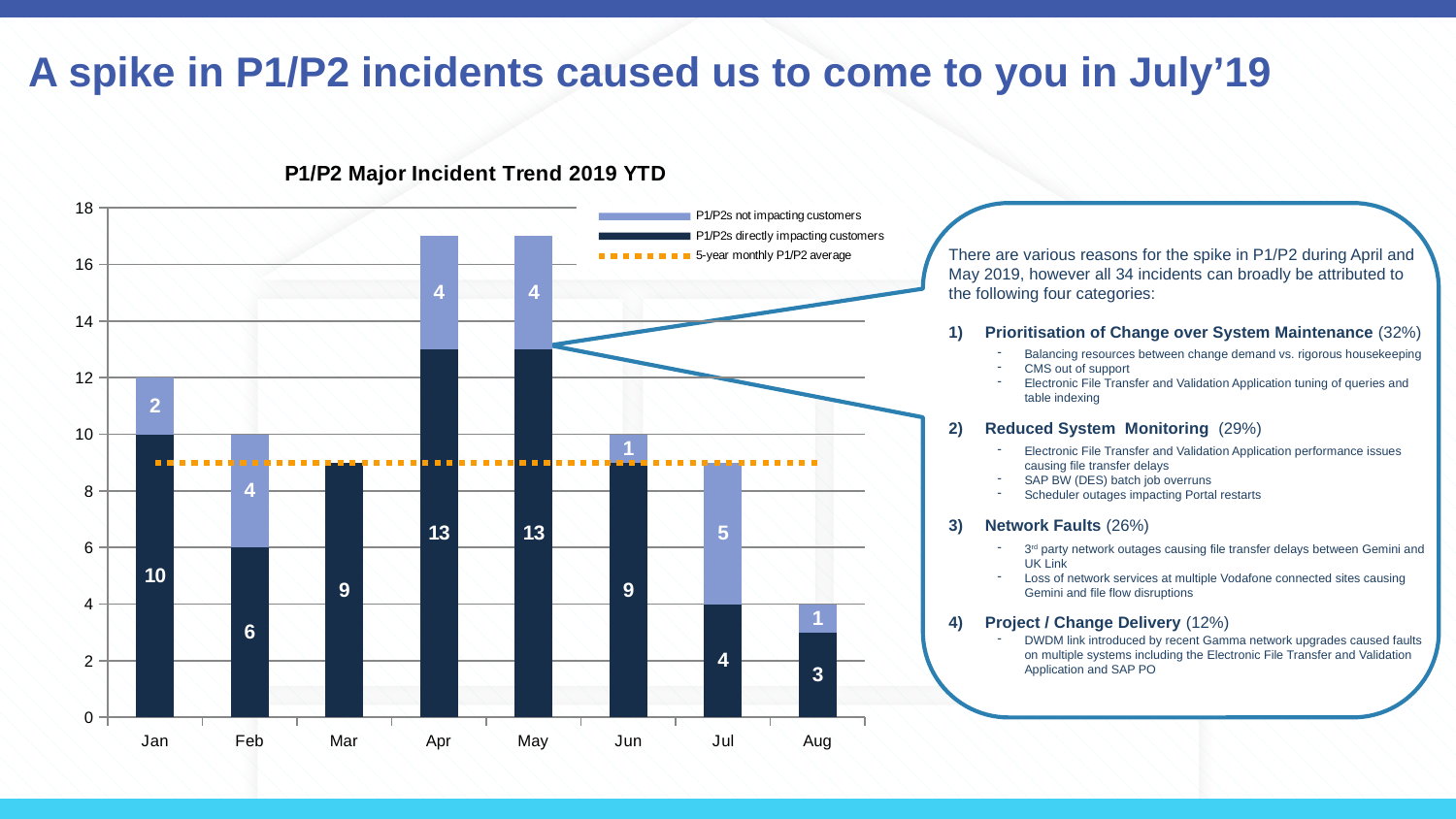
How many P1/P2s not impacting customers were there in Jul? 5 Is the 5-year monthly P1/P2 average line greater or less than 10? less What is the total height of the stacked bar for Aug? 4 What is the total height of the stacked bar for Apr? 17 What kind of chart is shown on the slide? Stacked bar chart Which month has the lowest number of P1/P2s directly impacting customers? Aug Which month has more P1/P2s not impacting customers, Feb or Jun? Feb How many P1/P2s directly impacting customers were there in Jan? 10 What is the difference between the P1/P2s directly impacting customers in Jan and in Feb? 4 How many months are shown on the x axis? 8 Which month has the highest number of P1/P2s not impacting customers? Jul How many entries does the legend list? 3